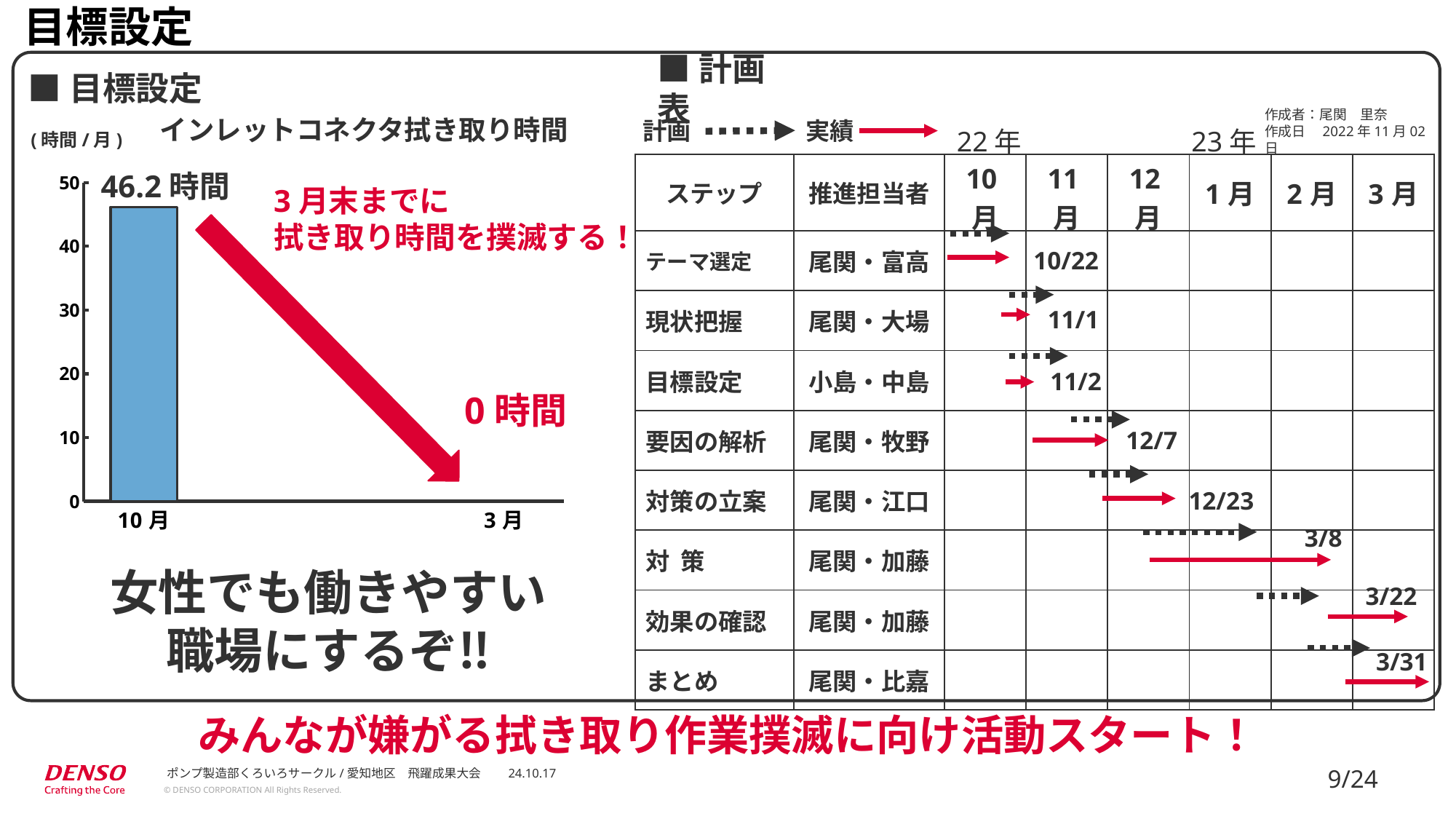
What unit is shown for the y axis of the bar chart インレットコネクタ拭き取り時間? 時間/月 In the bar chart インレットコネクタ拭き取り時間, is the value for 10月 greater or less than 50? less In the bar chart インレットコネクタ拭き取り時間, do the values rise or fall from 10月 to 3月? fall How many bars are plotted in the bar chart インレットコネクタ拭き取り時間? 1 In the bar chart インレットコネクタ拭き取り時間, which is larger, the 10月 value or the 3月 target? 10月 What kind of chart is the chart on the left of the slide? bar chart What is the title of the bar chart on the left of the slide? インレットコネクタ拭き取り時間 In the bar chart インレットコネクタ拭き取り時間, what is the value for 10月? 46.2時間 How many categories are labelled on the x axis of the bar chart インレットコネクタ拭き取り時間? 2 In the bar chart インレットコネクタ拭き取り時間, what target value is shown for 3月? 0時間 In the bar chart インレットコネクタ拭き取り時間, what is the difference between the 10月 value and the 3月 target? 46.2時間 In the bar chart インレットコネクタ拭き取り時間, is the value for 10月 greater or less than 40? greater